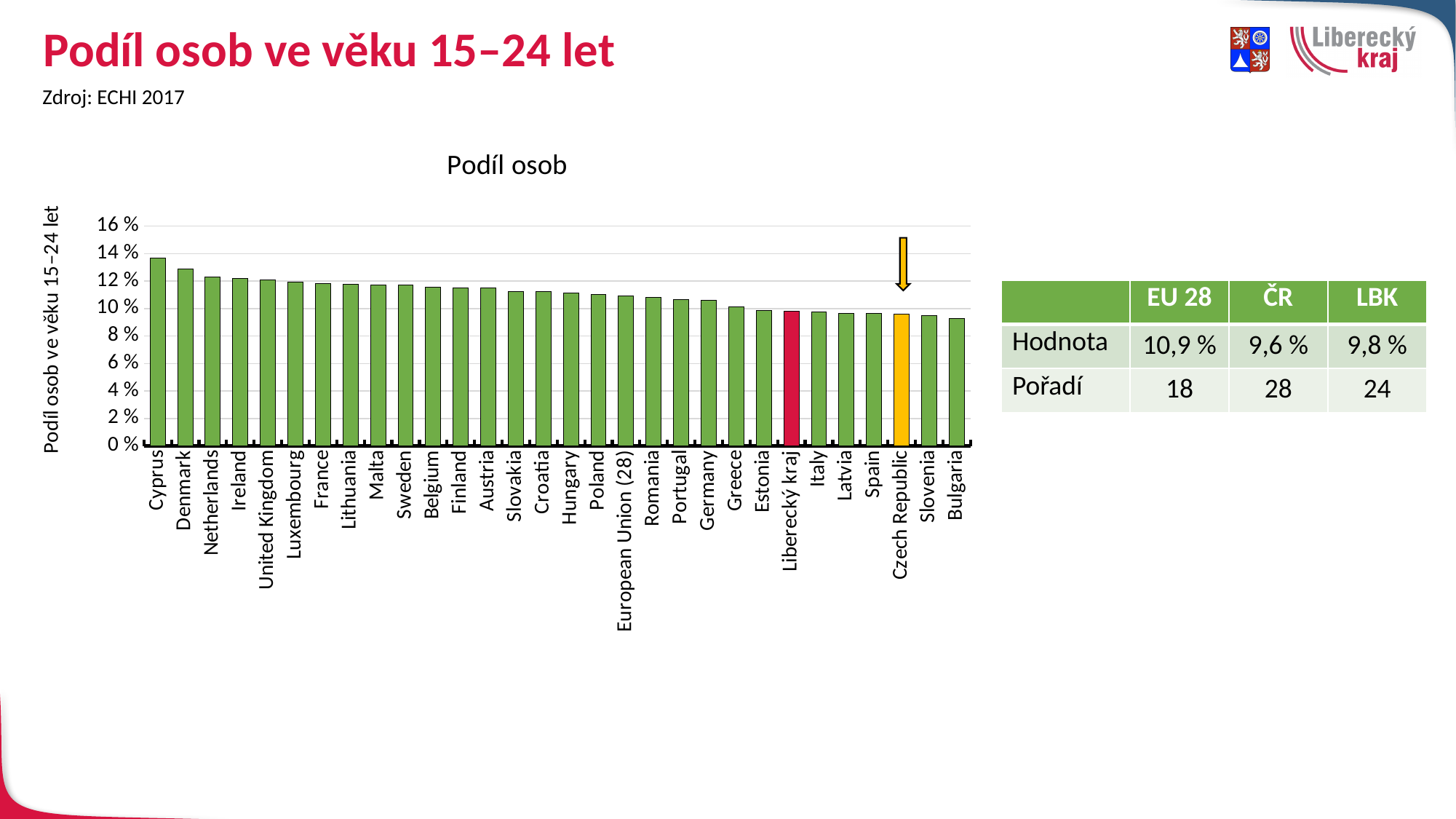
Do the values rise or fall from left to right along the x axis? fall Which is larger, the value for Denmark or the value for Netherlands? Denmark How many bars (categories) are plotted in the chart? 30 Which category has the highest value in the chart? Cyprus Which category has the lowest value in the chart? Bulgaria What kind of chart is shown on the slide? bar chart Is the value for Germany greater or less than 10 %? greater According to the table on the slide, what is the difference between the value for EU 28 and the value for ČR? 1,3 % According to the table on the slide, what is the value (Hodnota) for EU 28? 10,9 % Is the value for Bulgaria greater or less than 10 %? less What colour is the bar for Liberecký kraj? red Is the value for Cyprus greater or less than 12 %? greater